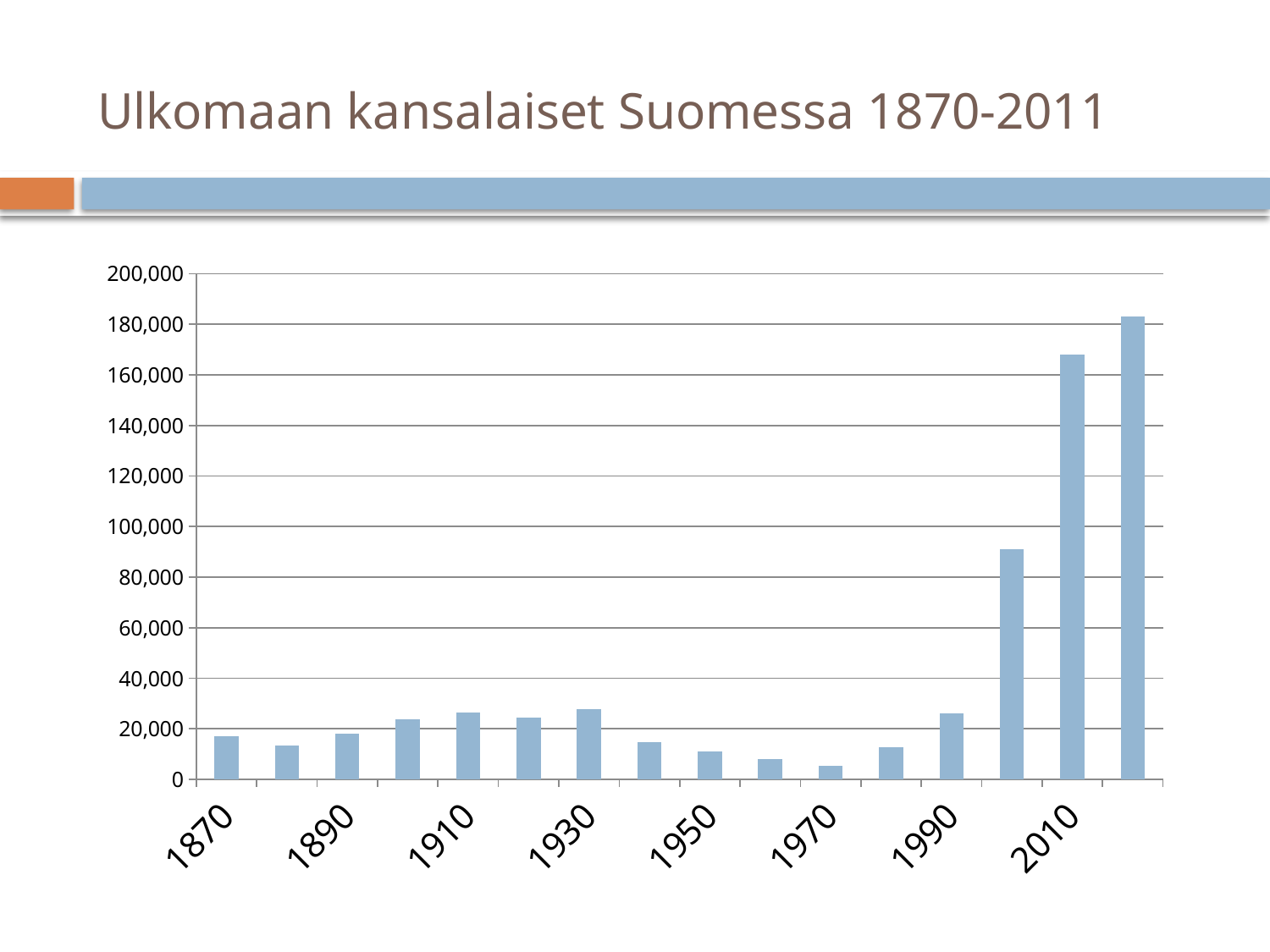
Is the value for 2010 greater or less than 160,000? greater Which bar is the tallest in the chart? the rightmost bar Do the values rise or fall from 1930 to 1970? fall What is the title of the slide? Ulkomaan kansalaiset Suomessa 1870-2011 Is the value for 1970 greater or less than 20,000? less What kind of chart is shown on the slide? bar chart Which is larger, the value for 2010 or the value for 1990? 2010 Which labelled year has the lowest bar in the chart? 1970 How many bars are plotted in the chart? 16 Which is larger, the value for 1930 or the value for 1950? 1930 Is the value for 1990 greater or less than 40,000? less